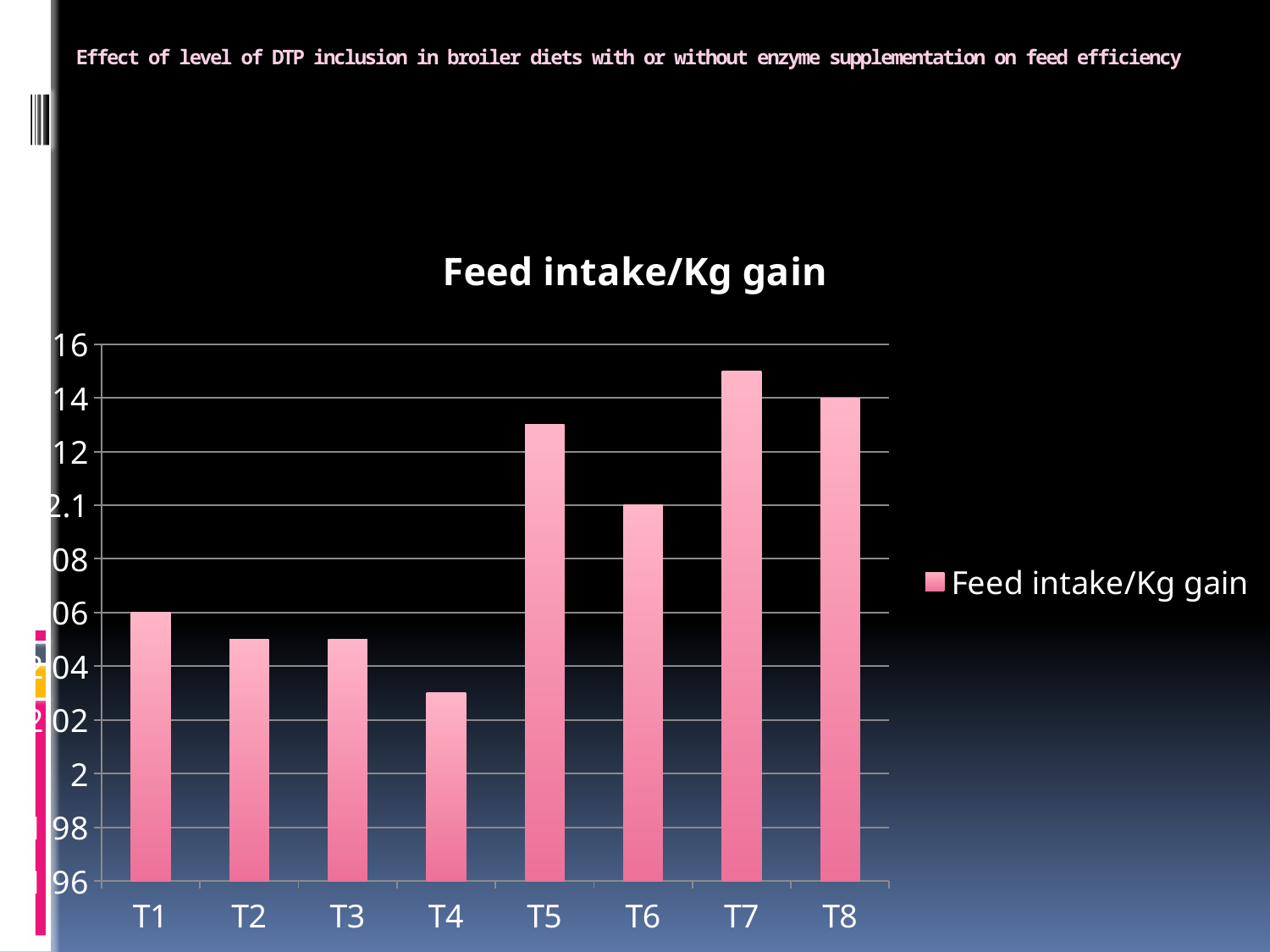
Which category has the highest feed intake/Kg gain? T7 What is the feed intake/Kg gain value for T6? 2.1 Which category has the lowest feed intake/Kg gain? T4 What type of chart is shown on the slide? bar chart Which has a larger value, T5 or T6? T5 Is the value for T1 greater or less than 2? greater How many categories are shown on the x axis of the chart? 8 Which has a larger value, T1 or T4? T1 Is the value for T4 greater or less than 2.1? less What is the title of the chart? Feed intake/Kg gain Is the value for T7 greater or less than 2.1? greater How many series does the chart legend list? 1